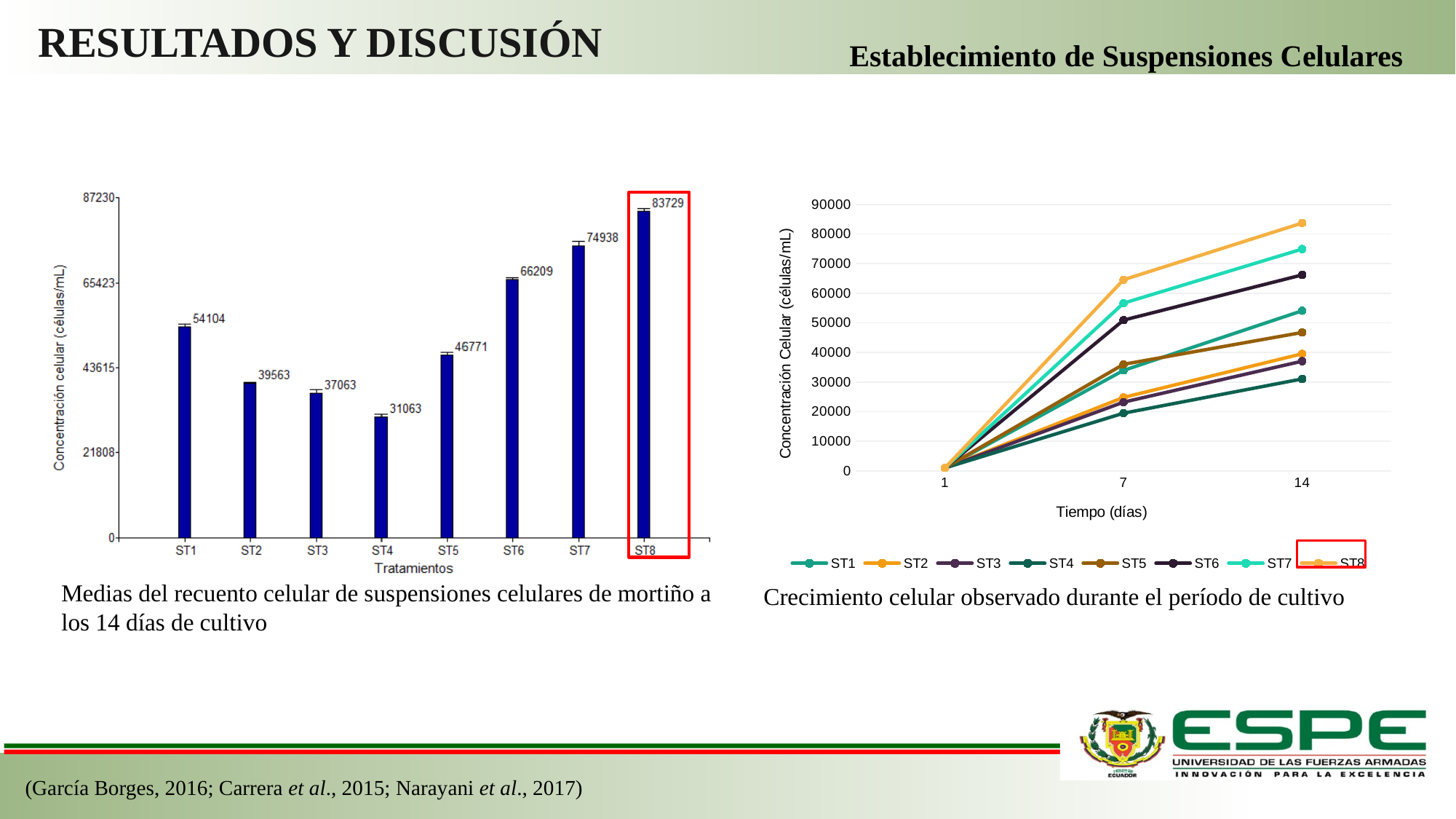
How many treatments are shown in the left bar chart? 8 In the left bar chart, what is the value for ST4? 31063 What kind of chart is the chart on the left of the slide? bar chart In the left bar chart, which treatment has the lowest cell concentration? ST4 In the right line chart, do the values for ST8 rise or fall from day 1 to day 14? rise In the right line chart, is the value for ST8 at day 14 greater or less than 80000? greater How many series does the legend of the right chart list? 8 In the left bar chart, what is the value for ST8? 83729 In the left bar chart, what is the difference between the values for ST8 and ST7? 8791 In the left bar chart, which is larger, the value for ST2 or the value for ST5? ST5 In the left bar chart, which treatment has the highest cell concentration? ST8 In the right line chart, is the value for ST4 at day 14 greater or less than 40000? less